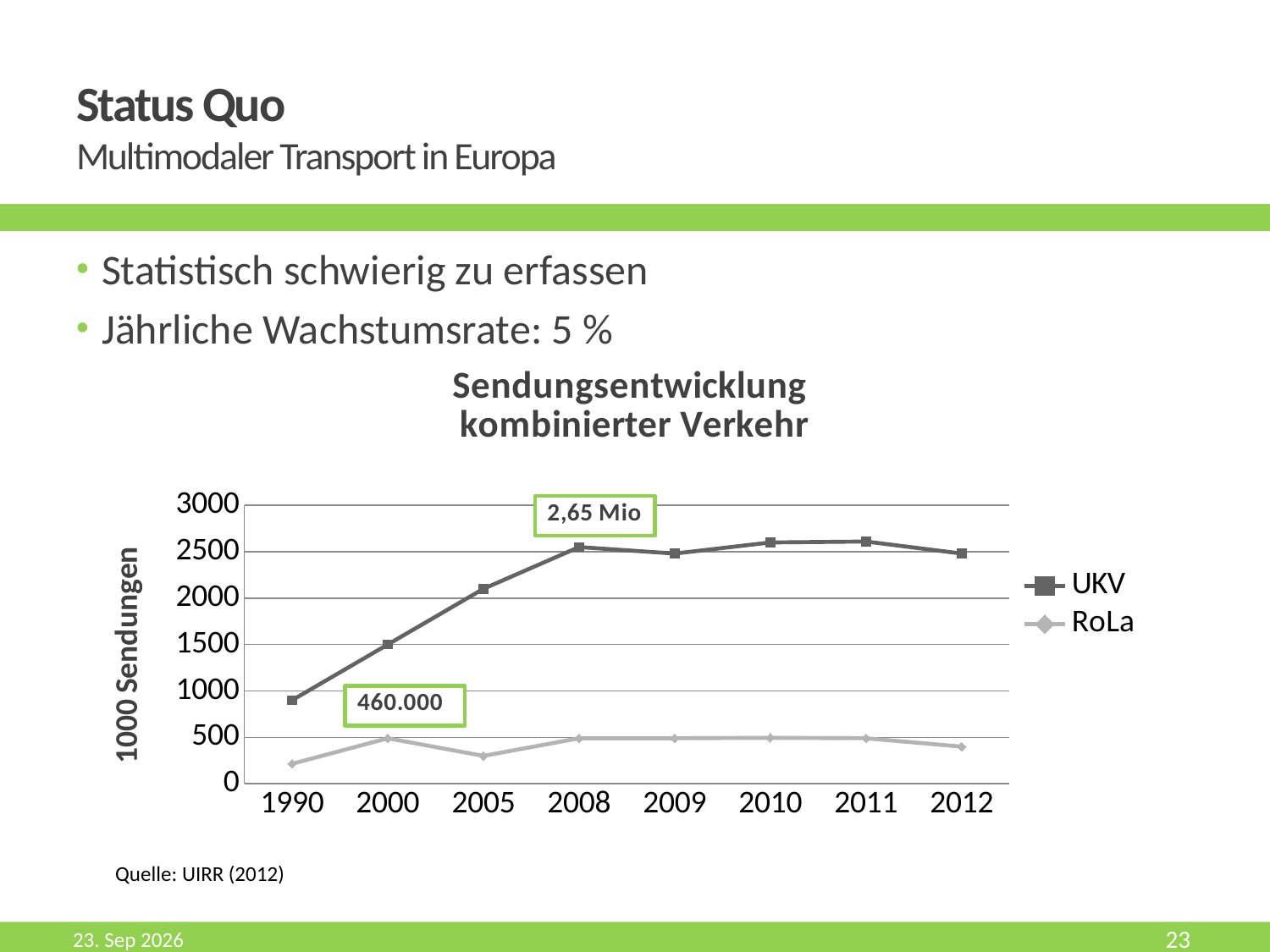
Which series are listed in the chart's legend? UKV and RoLa What is the label of the vertical axis of the chart? 1000 Sendungen What kind of chart is shown on the slide? line chart In which year is the UKV series at its lowest? 1990 Which series has the larger value in 2012, UKV or RoLa? UKV How many years are shown on the x axis of the chart? 8 Does the UKV series rise or fall from 1990 to 2008? rise In which year is the RoLa series at its lowest? 1990 Is the UKV value for 2005 greater or less than 2000? greater How many series does the legend of the chart list? 2 Is the RoLa value for 2005 greater or less than 500? less Is the UKV value for 1990 greater or less than 1000? less